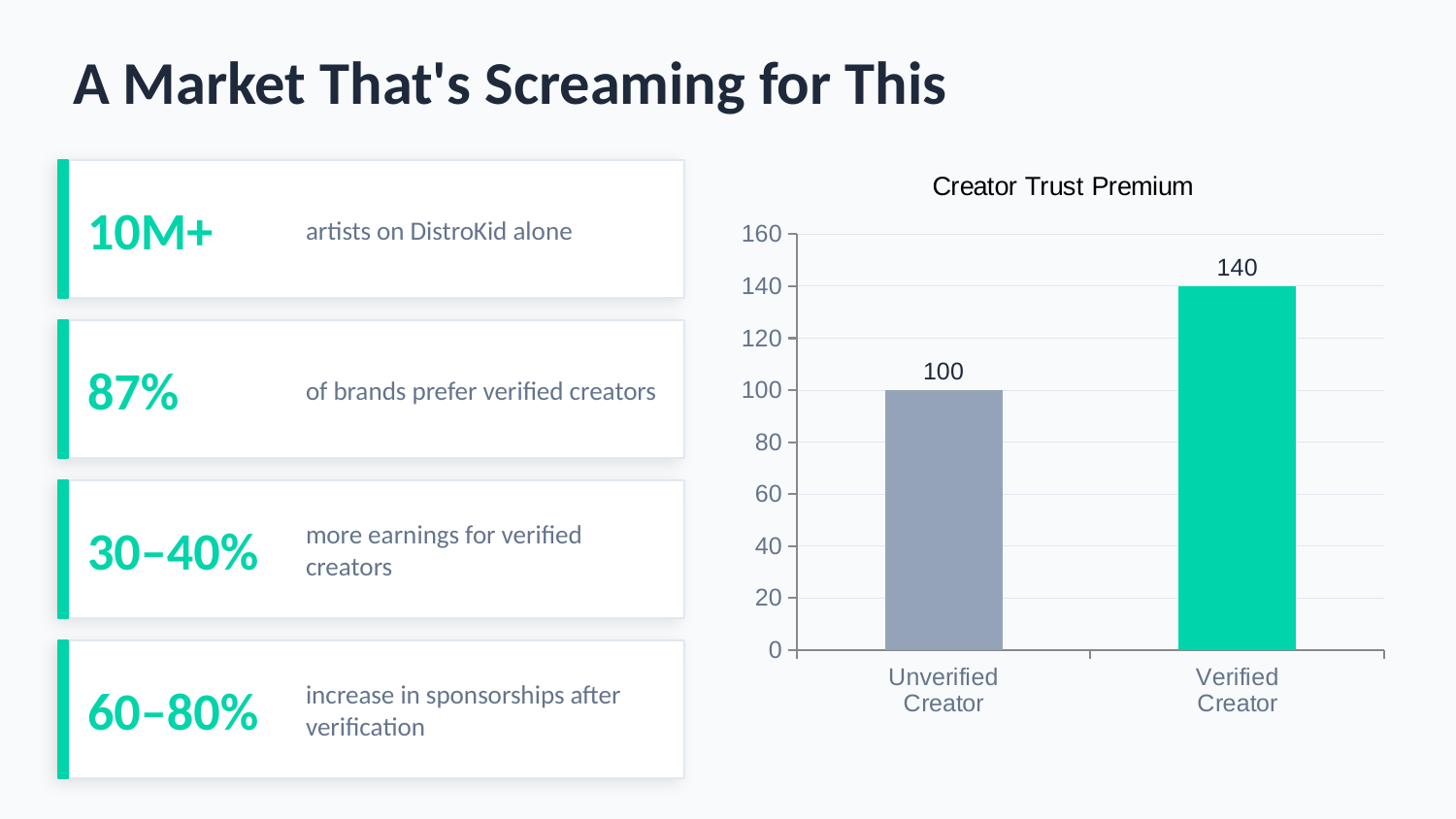
How many categories are shown in the Creator Trust Premium chart? 2 What kind of chart is the Creator Trust Premium chart? bar chart Which is larger in the Creator Trust Premium chart: Unverified Creator or Verified Creator? Verified Creator What is the difference between the Verified Creator and Unverified Creator values in the Creator Trust Premium chart? 40 What is the maximum value shown on the y axis of the Creator Trust Premium chart? 160 What is the value for Unverified Creator in the Creator Trust Premium chart? 100 Is the value for Unverified Creator greater or less than 120? less What is the value for Verified Creator in the Creator Trust Premium chart? 140 Which category has the highest value in the Creator Trust Premium chart? Verified Creator Is the value for Verified Creator greater or less than 120? greater Which category has the lowest value in the Creator Trust Premium chart? Unverified Creator What is the title of the chart on the slide? Creator Trust Premium